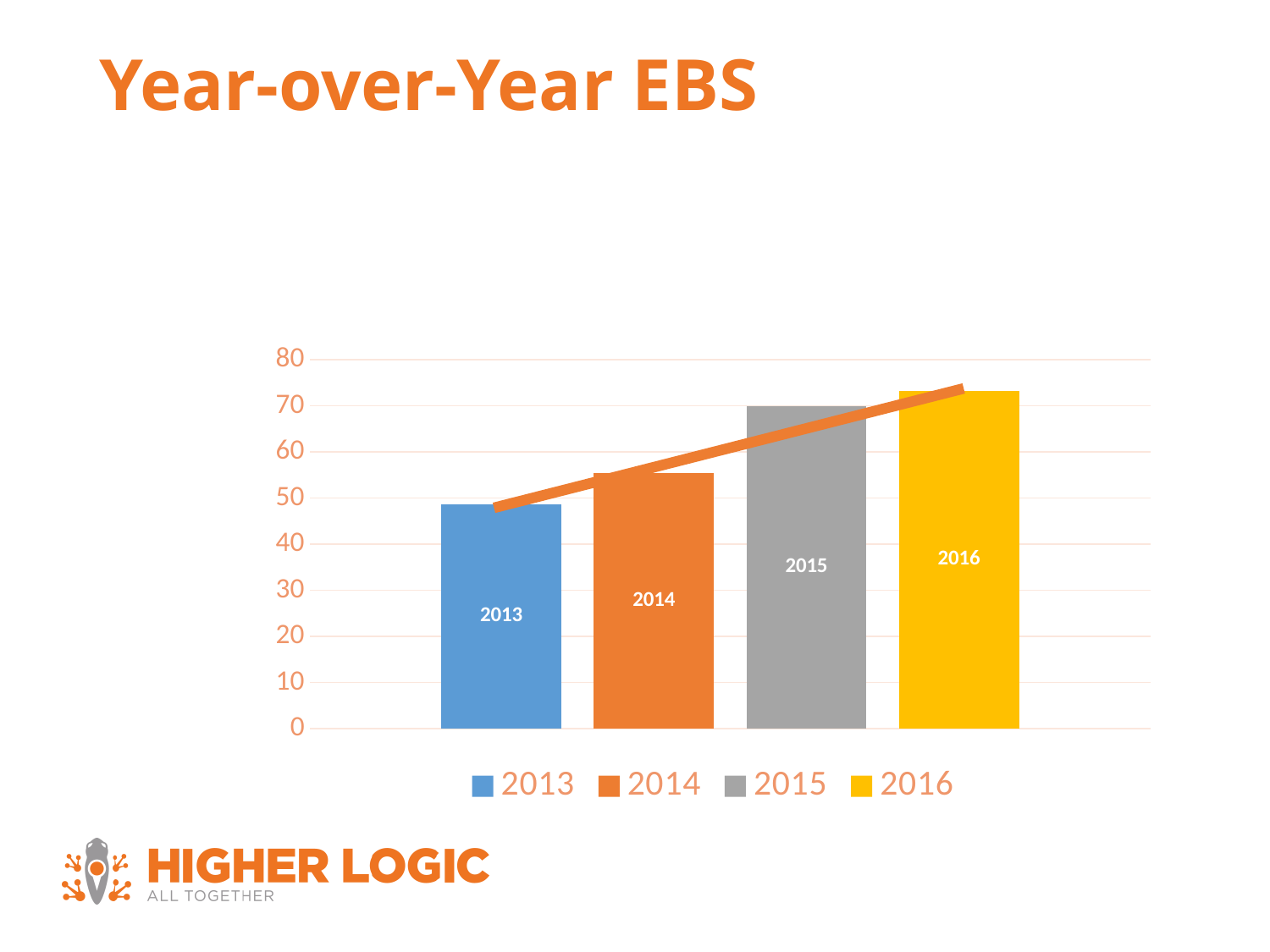
Which is larger, the value for 2013 or the value for 2014? 2014 Which year has the highest bar? 2016 Is the value for 2015 greater or less than 80? less What kind of chart is shown on the slide? bar chart What is the title of the slide containing the chart? Year-over-Year EBS Is the value for 2016 greater or less than 70? greater Is the value for 2013 greater or less than 50? less Which year has the lowest bar? 2013 How many entries does the legend list? 4 Do the values rise or fall from 2013 to 2016? rise How many bars are plotted in the chart? 4